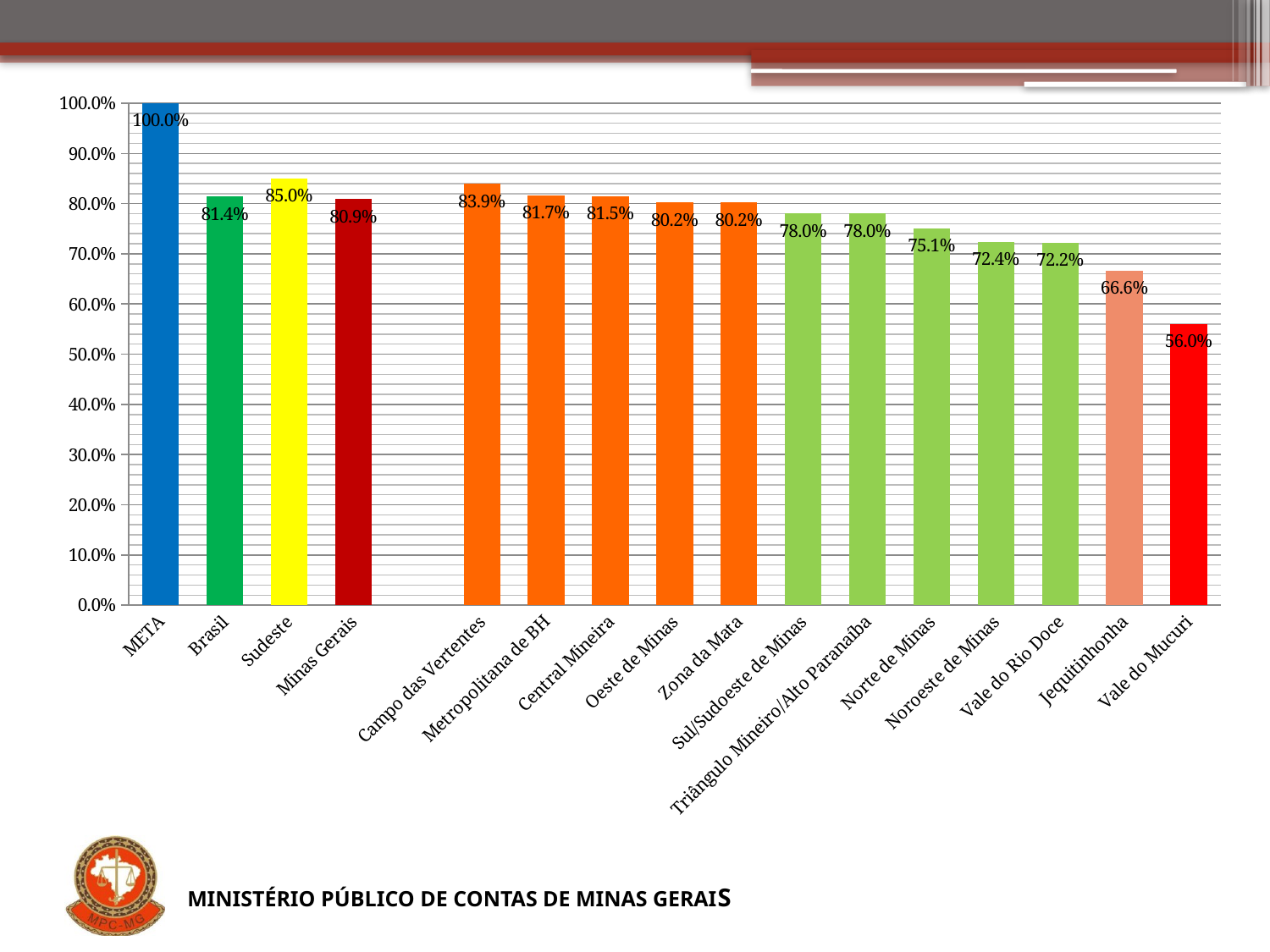
What is the value for Minas Gerais? 80.9% Which category has the highest value? META What is the value for Jequitinhonha? 66.6% Is the value for Vale do Rio Doce greater or less than 80.0%? less What is the value for Sudeste? 85.0% What is the value for Norte de Minas? 75.1% How many bars are shown in the chart? 16 What is the difference between the values for META and Vale do Mucuri? 44.0% Which category has the lowest value? Vale do Mucuri What kind of chart is shown on the slide? bar chart Which is larger, the value for Campo das Vertentes or the value for Metropolitana de BH? Campo das Vertentes What is the difference between the values for Sudeste and Brasil? 3.6%